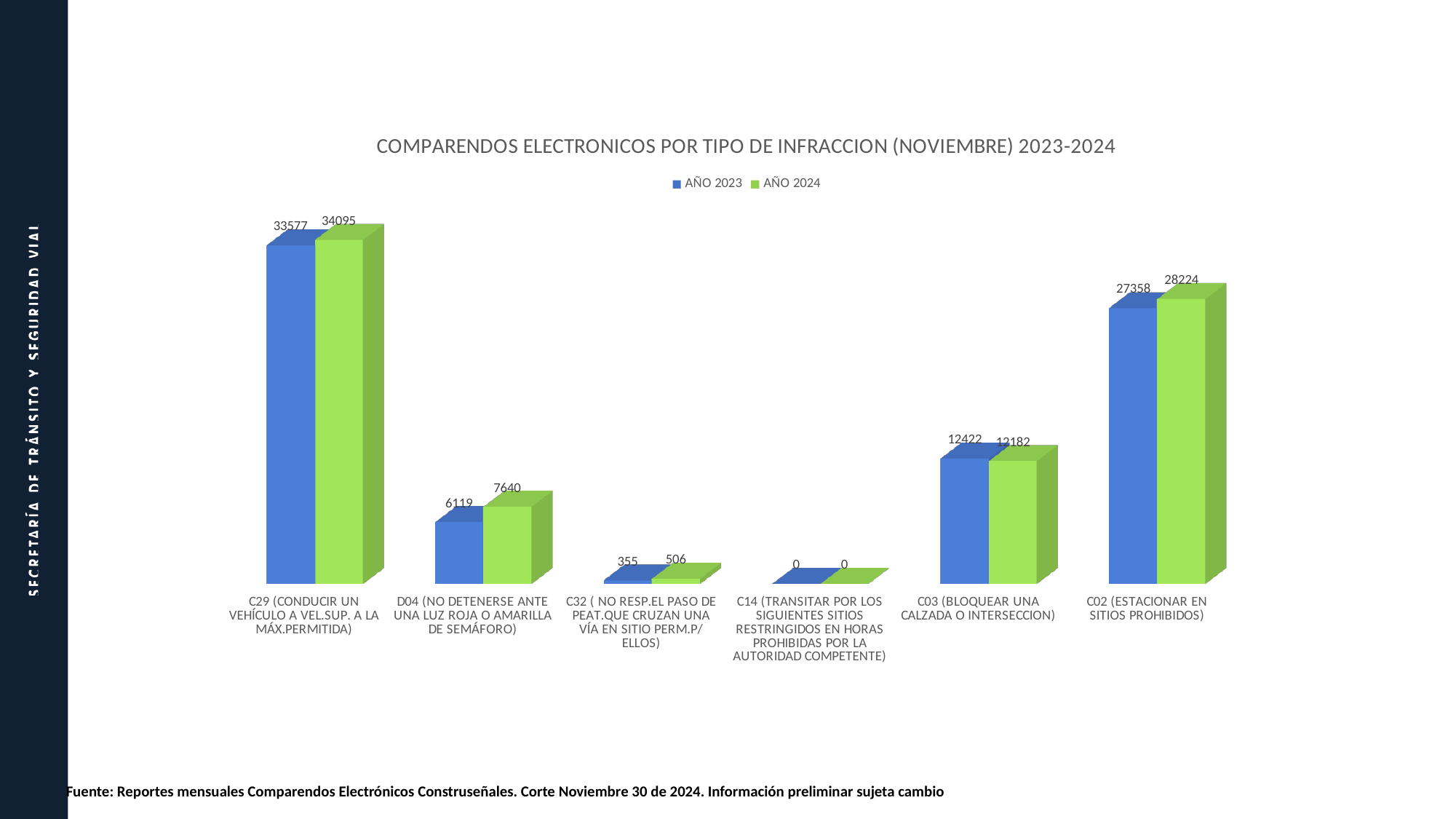
How many infraction categories are shown on the x axis? 6 What is the value for AÑO 2024 for D04 (NO DETENERSE ANTE UNA LUZ ROJA O AMARILLA DE SEMÁFORO)? 7640 What is the difference between the AÑO 2023 and AÑO 2024 values for C03 (BLOQUEAR UNA CALZADA O INTERSECCION)? 240 Which category has the lowest value for AÑO 2023? C14 (TRANSITAR POR LOS SIGUIENTES SITIOS RESTRINGIDOS EN HORAS PROHIBIDAS POR LA AUTORIDAD COMPETENTE) How many series does the legend list? 2 What is the title of the chart? COMPARENDOS ELECTRONICOS POR TIPO DE INFRACCION (NOVIEMBRE) 2023-2024 What is the value for AÑO 2023 for C02 (ESTACIONAR EN SITIOS PROHIBIDOS)? 27358 What is the value for AÑO 2023 for C29 (CONDUCIR UN VEHÍCULO A VEL.SUP. A LA MÁX.PERMITIDA)? 33577 For C32 ( NO RESP.EL PASO DE PEAT.QUE CRUZAN UNA VÍA EN SITIO PERM.P/ ELLOS), which year has the larger value, AÑO 2023 or AÑO 2024? AÑO 2024 What kind of chart is shown on the slide? Bar chart Which category has the highest value for AÑO 2024? C29 (CONDUCIR UN VEHÍCULO A VEL.SUP. A LA MÁX.PERMITIDA) What is the difference between the AÑO 2024 and AÑO 2023 values for C02 (ESTACIONAR EN SITIOS PROHIBIDOS)? 866